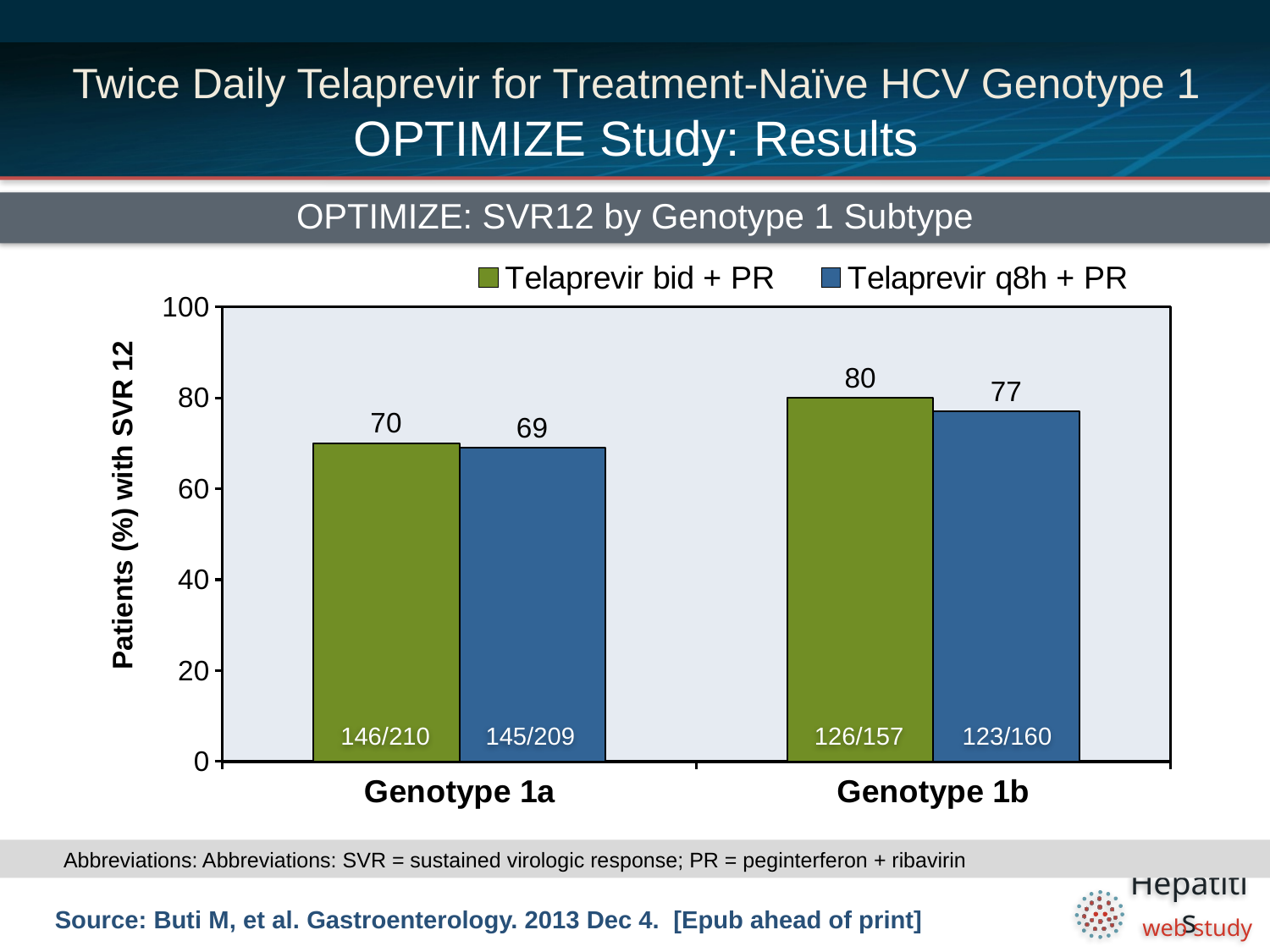
Which bar has the lowest SVR12 rate? Telaprevir q8h + PR, Genotype 1a How many series does the legend list? 2 What is the SVR12 rate for Telaprevir bid + PR in Genotype 1a? 70 Which is larger: the Telaprevir bid + PR rate for Genotype 1a or for Genotype 1b? Genotype 1b Is the value for Telaprevir q8h + PR in Genotype 1a greater or less than 80? less How many genotype subtype categories are shown on the x axis? 2 What is the difference in SVR12 rate between Telaprevir bid + PR and Telaprevir q8h + PR in Genotype 1b? 3 What fraction of patients is shown inside the Telaprevir bid + PR bar for Genotype 1b? 126/157 What kind of chart is shown on the slide? Bar chart What is the SVR12 rate for Telaprevir q8h + PR in Genotype 1a? 69 What is the SVR12 rate for Telaprevir q8h + PR in Genotype 1b? 77 Which bar has the highest SVR12 rate? Telaprevir bid + PR, Genotype 1b